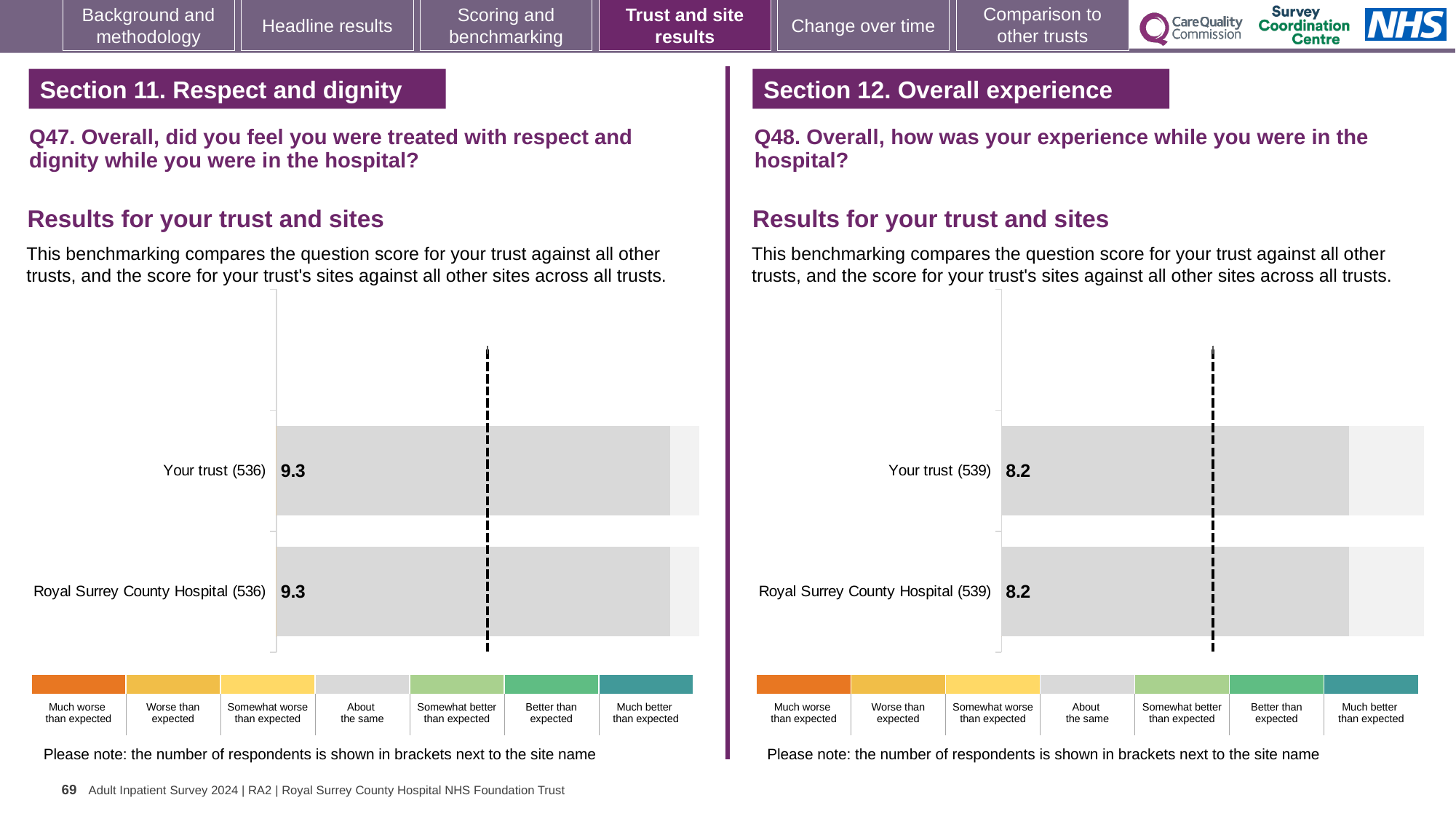
On the Q47 chart (Section 11. Respect and dignity), what is the difference between the Your trust score and the Royal Surrey County Hospital score? 0 On the Q47 chart (Section 11. Respect and dignity), what is the score for Royal Surrey County Hospital? 9.3 On the Q48 chart (Section 12. Overall experience), how many bars are plotted? 2 On the Q47 chart (Section 11. Respect and dignity), how many bars are plotted? 2 What kind of chart is used on the Q47 chart (Section 11. Respect and dignity)? Bar chart On the Q47 chart (Section 11. Respect and dignity), what is the score for Your trust? 9.3 On the Q48 chart (Section 12. Overall experience), what is the score for Your trust? 8.2 On the Q48 chart (Section 12. Overall experience), how many respondents are shown in brackets for Your trust? 539 On the Q47 chart (Section 11. Respect and dignity), how many respondents are shown in brackets for Royal Surrey County Hospital? 536 Which chart shows the higher score for Your trust: the Q47 chart (Section 11) or the Q48 chart (Section 12)? Q47 chart (Section 11) On the Q48 chart (Section 12. Overall experience), what is the score for Royal Surrey County Hospital? 8.2 On the Q48 chart (Section 12. Overall experience), what is the label of the rightmost category in the colour key below the chart? Much better than expected